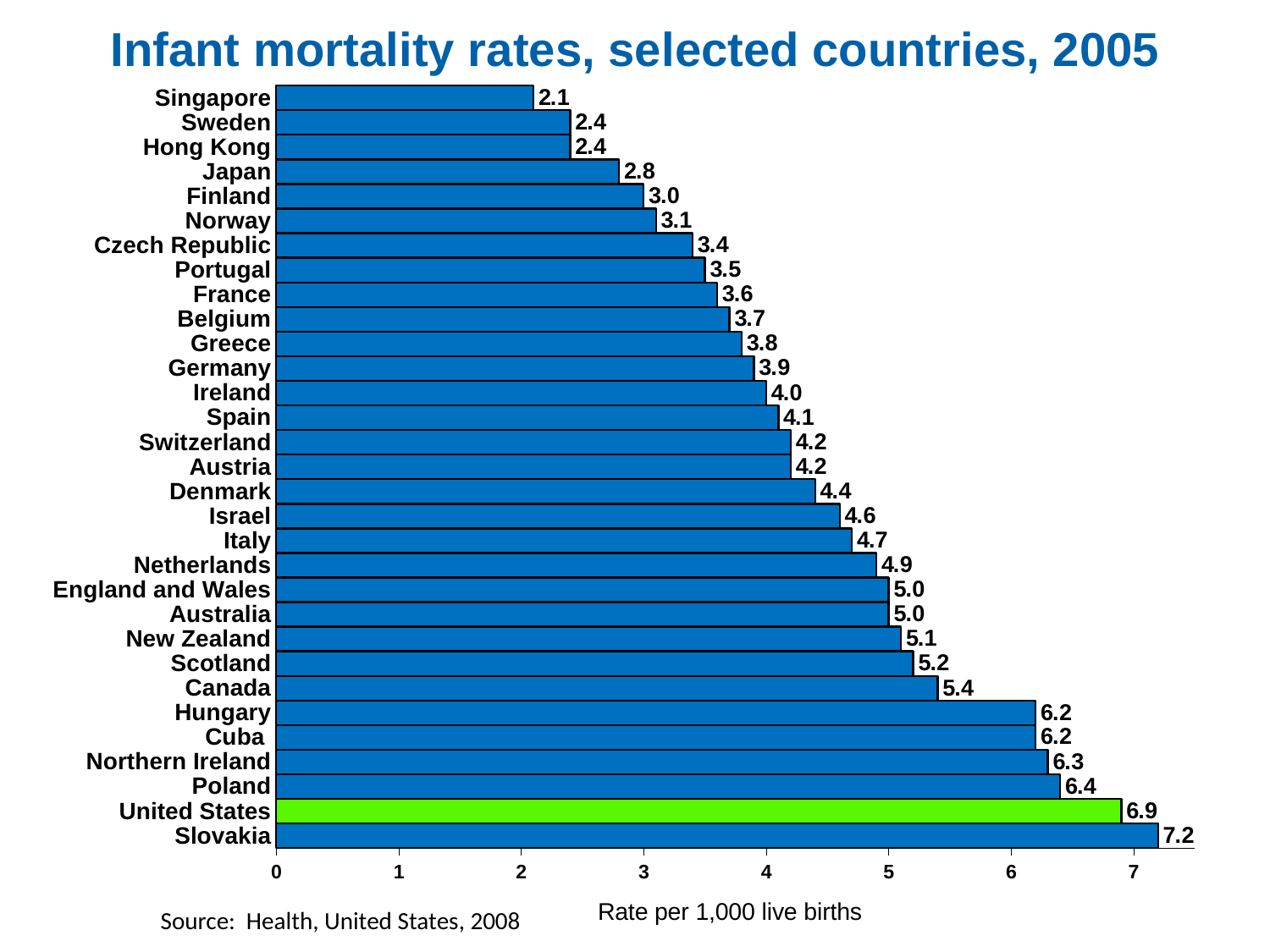
What kind of chart is shown on the slide? Bar chart Which country has the lowest infant mortality rate on the chart? Singapore Is the value for Netherlands greater or less than 5? less What is the infant mortality rate for the United States? 6.9 How many countries are shown on the chart? 31 Which has a higher infant mortality rate, Poland or Hungary? Poland What is the difference between the infant mortality rates of Slovakia and the United States? 0.3 What is the difference between the infant mortality rates of the United States and Singapore? 4.8 Which country has the highest infant mortality rate on the chart? Slovakia Which country's bar is highlighted in green? United States What is the infant mortality rate for Canada? 5.4 What is the infant mortality rate for Japan? 2.8